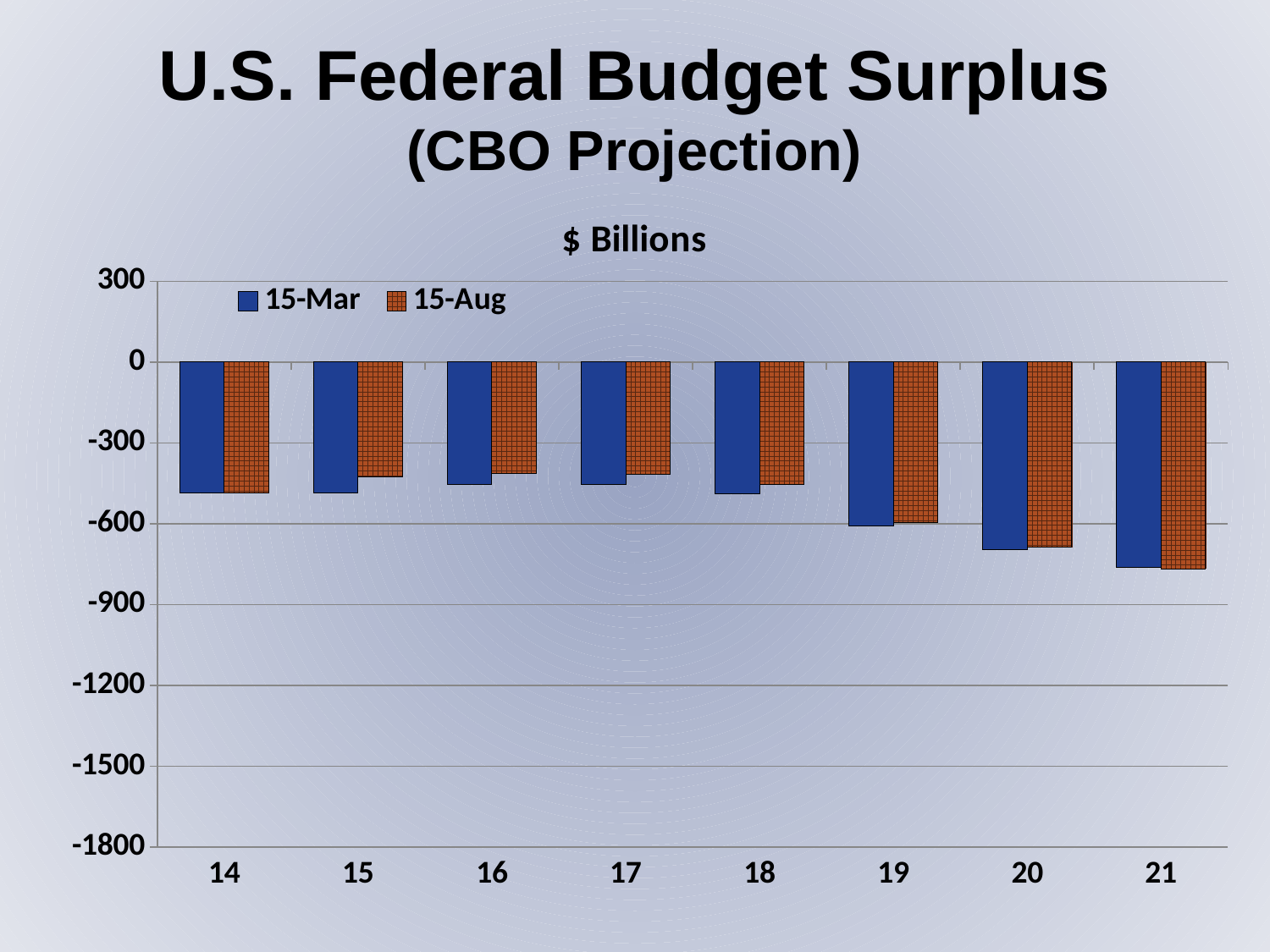
What kind of chart is shown on the slide? bar chart What unit label appears above the chart? $ Billions Is the 15-Mar value for 21 greater or less than -600? less What are the two series named in the legend? 15-Mar and 15-Aug Is the 15-Aug value for 20 greater or less than -900? greater From 18 to 21, do the 15-Aug values rise or fall? fall For 16, which series has the larger value, 15-Mar or 15-Aug? 15-Aug Is the 15-Mar value for 14 greater or less than -300? less How many series does the legend list? 2 Which year has the lowest 15-Mar value? 21 How many years are shown along the x axis? 8